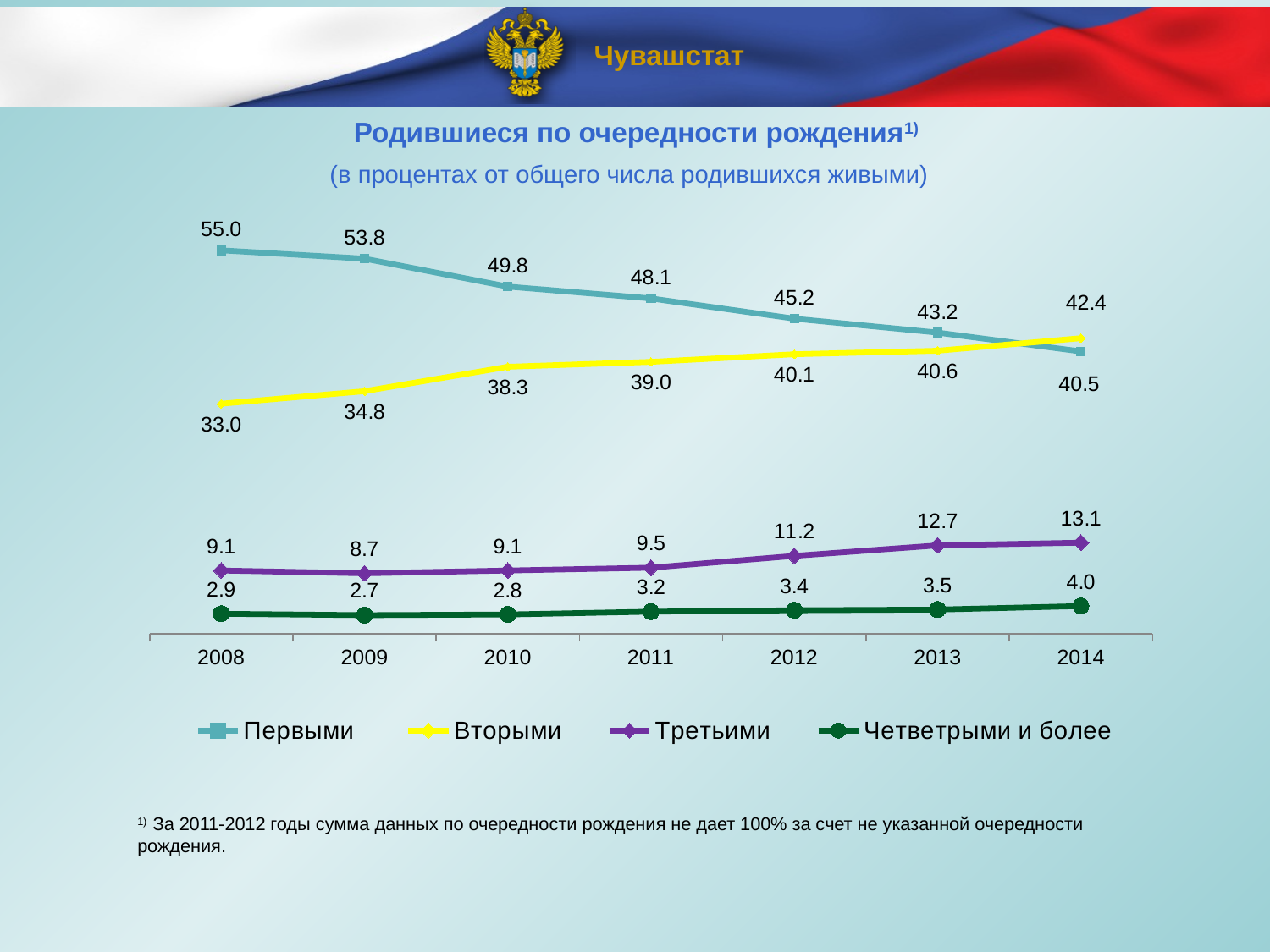
Which series has the larger value in 2014, Первыми or Вторыми? Вторыми How many series does the legend list? 4 What is the value for Третьими in 2012? 11.2 In which year is the value for Первыми the lowest? 2014 What is the difference between the Первыми values in 2008 and 2014? 14.5 What type of chart is shown on the slide? line chart Does the value for Вторыми rise or fall from 2008 to 2014? rise What is the value for Вторыми in 2014? 42.4 In which year is the value for Третьими the highest? 2014 How many years are shown on the x axis? 7 What is the value for Четвертыми и более in 2009? 2.7 What is the value for Первыми in 2008? 55.0